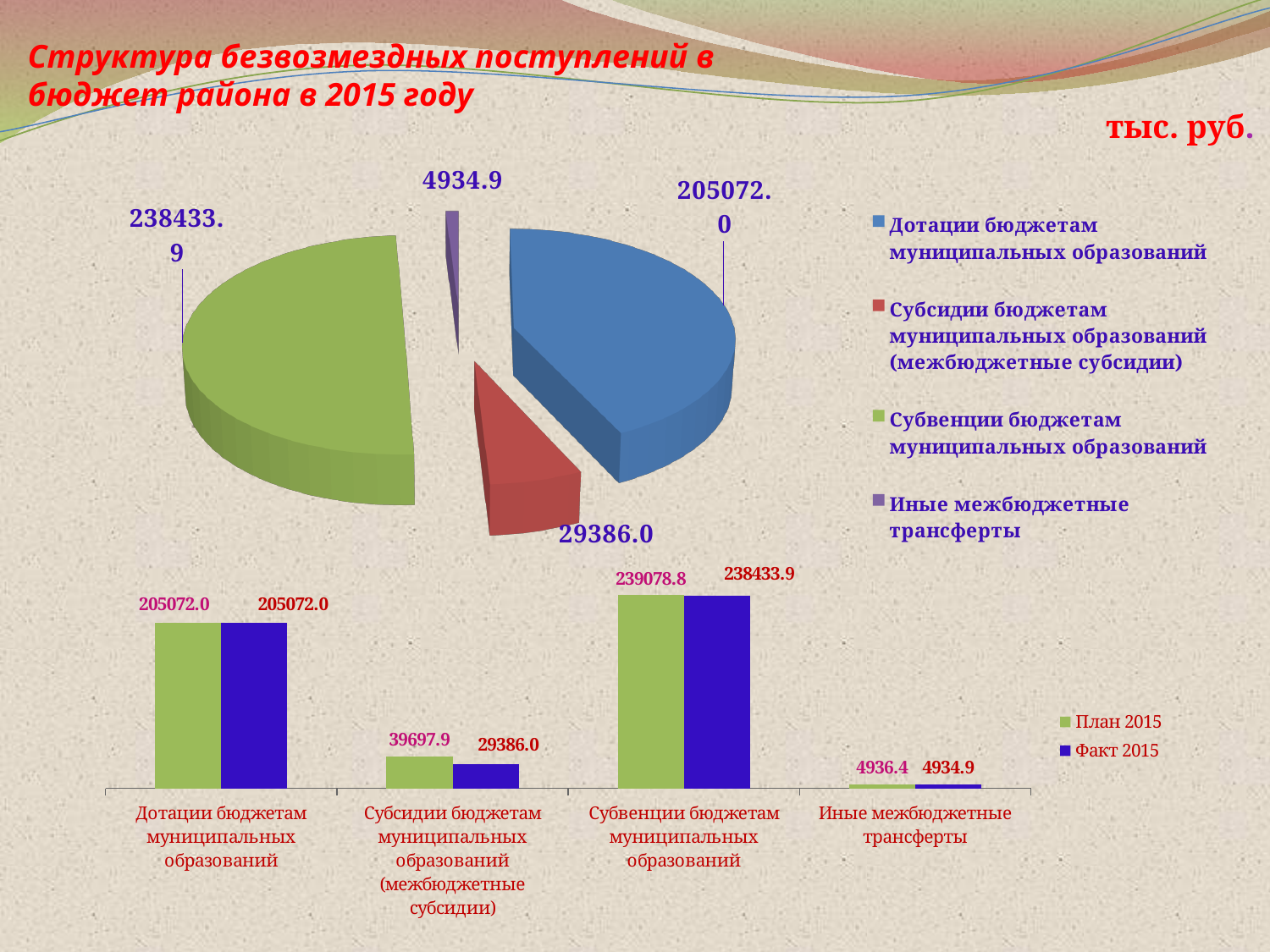
In the bar chart, what is the difference between План 2015 and Факт 2015 for Субсидии бюджетам муниципальных образований (межбюджетные субсидии)? 10311.9 How many categories are shown in the bar chart? 4 In the pie chart, what is the value for Дотации бюджетам муниципальных образований? 205072.0 What type of chart is the top chart on the slide? pie chart In the bar chart, which is larger for Субвенции бюджетам муниципальных образований: План 2015 or Факт 2015? План 2015 In the pie chart, which category has the smallest value? Иные межбюджетные трансферты How many series does the legend of the bar chart list? 2 In the pie chart, what is the value for Иные межбюджетные трансферты? 4934.9 What type of chart is the bottom chart on the slide? bar chart In the pie chart, which category has the largest value? Субвенции бюджетам муниципальных образований In the bar chart, what is the Факт 2015 value for Субвенции бюджетам муниципальных образований? 238433.9 In the bar chart, what is the План 2015 value for Субсидии бюджетам муниципальных образований (межбюджетные субсидии)? 39697.9